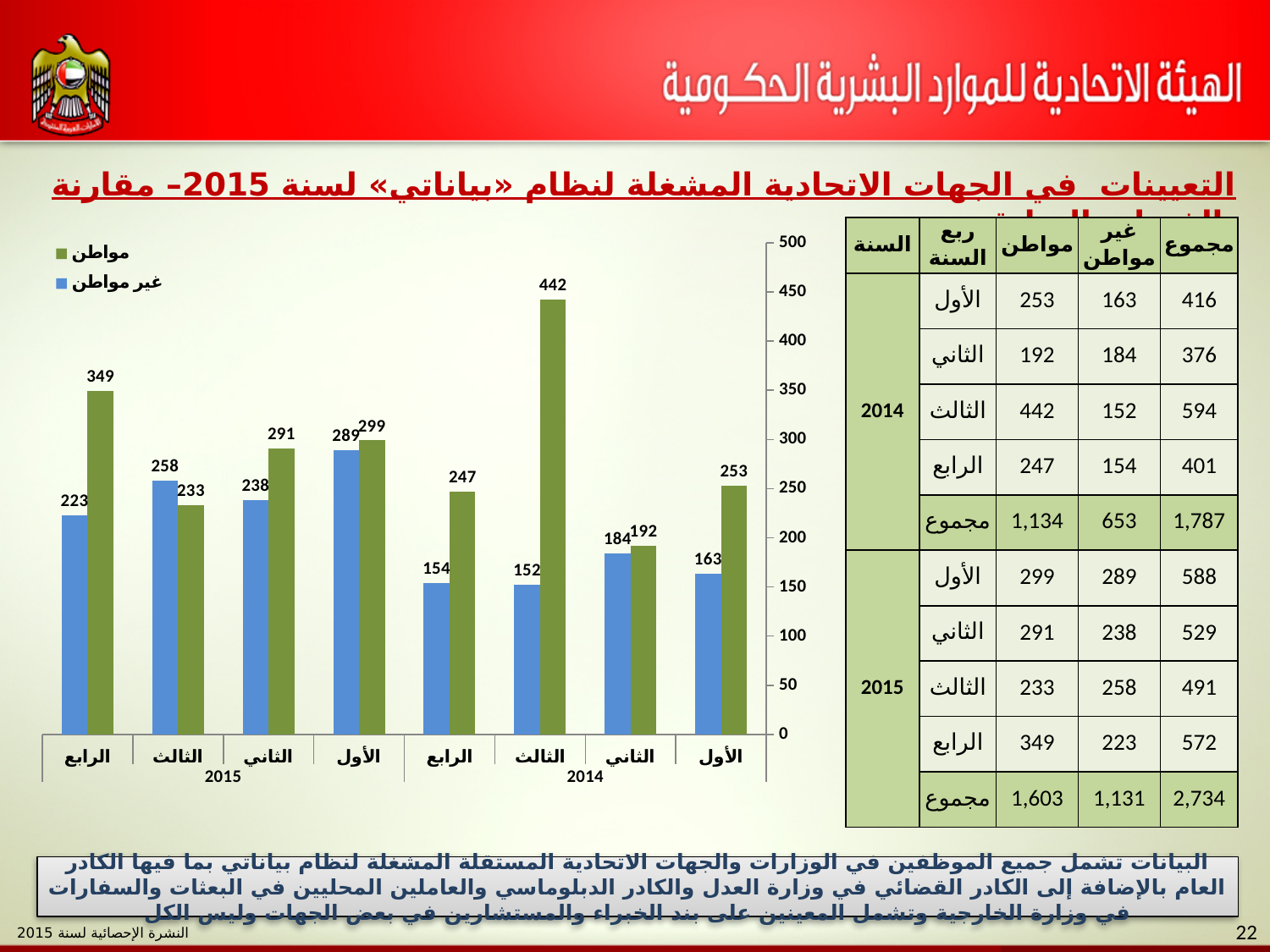
For الثالث in 2015, which is larger: مواطن or غير مواطن? غير مواطن What is the difference between the مواطن and غير مواطن values for الرابع in 2015? 126 What is the value of غير مواطن for الأول in 2015? 289 What is the value of غير مواطن for الرابع in 2015? 223 Which quarter has the lowest غير مواطن value in the chart? الثالث 2014 How many series does the chart legend list? 2 Which quarter has the highest مواطن value in the chart? الثالث 2014 Is the مواطن value for الثالث in 2014 greater or less than 400? greater How many quarter categories are shown on the x axis of the chart? 8 Which colour represents the مواطن series in the chart? green What type of chart is shown on the slide? bar chart What is the value of مواطن for الثالث in 2014? 442